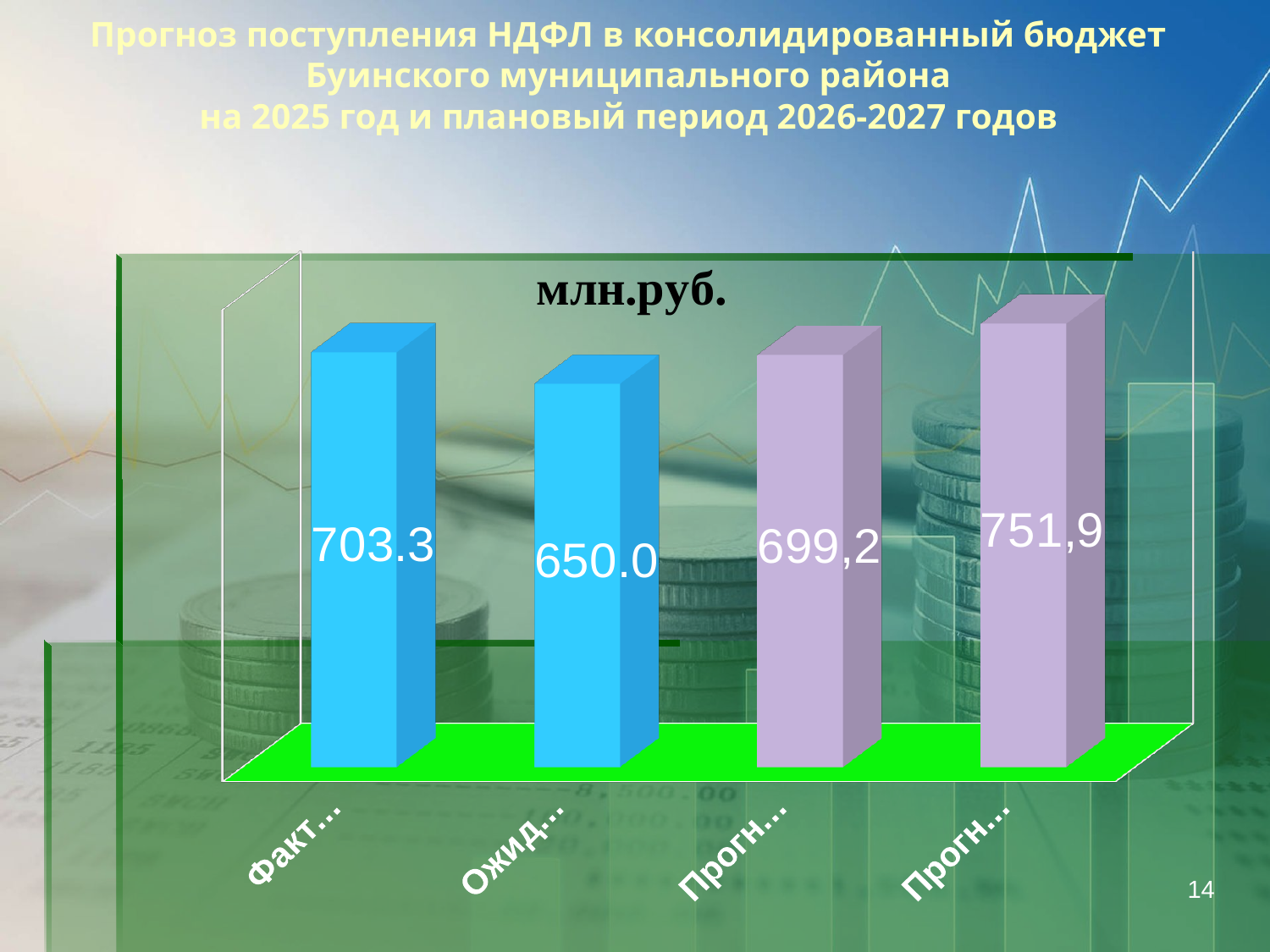
What is the title printed above the chart? млн.руб. What is the difference between the rightmost bar (751,9) and the third bar (699,2)? 52,7 What is the difference between the first bar (703.3) and the second bar (650.0)? 53.3 How many bars are plotted in the chart? 4 What is the value shown on the third bar from the left? 699,2 Which is larger: the value of the leftmost bar or the value of the third bar? The leftmost bar (703.3) Which bar has the lowest value? The second bar from the left, Ожид… (650.0) What is the value shown on the rightmost bar? 751,9 Which bar has the highest value? The rightmost bar (751,9) What type of chart is shown on the slide? Bar chart What is the value shown on the second bar from the left (Ожид…)? 650.0 What is the value shown on the leftmost bar (Факт…) of the chart? 703.3